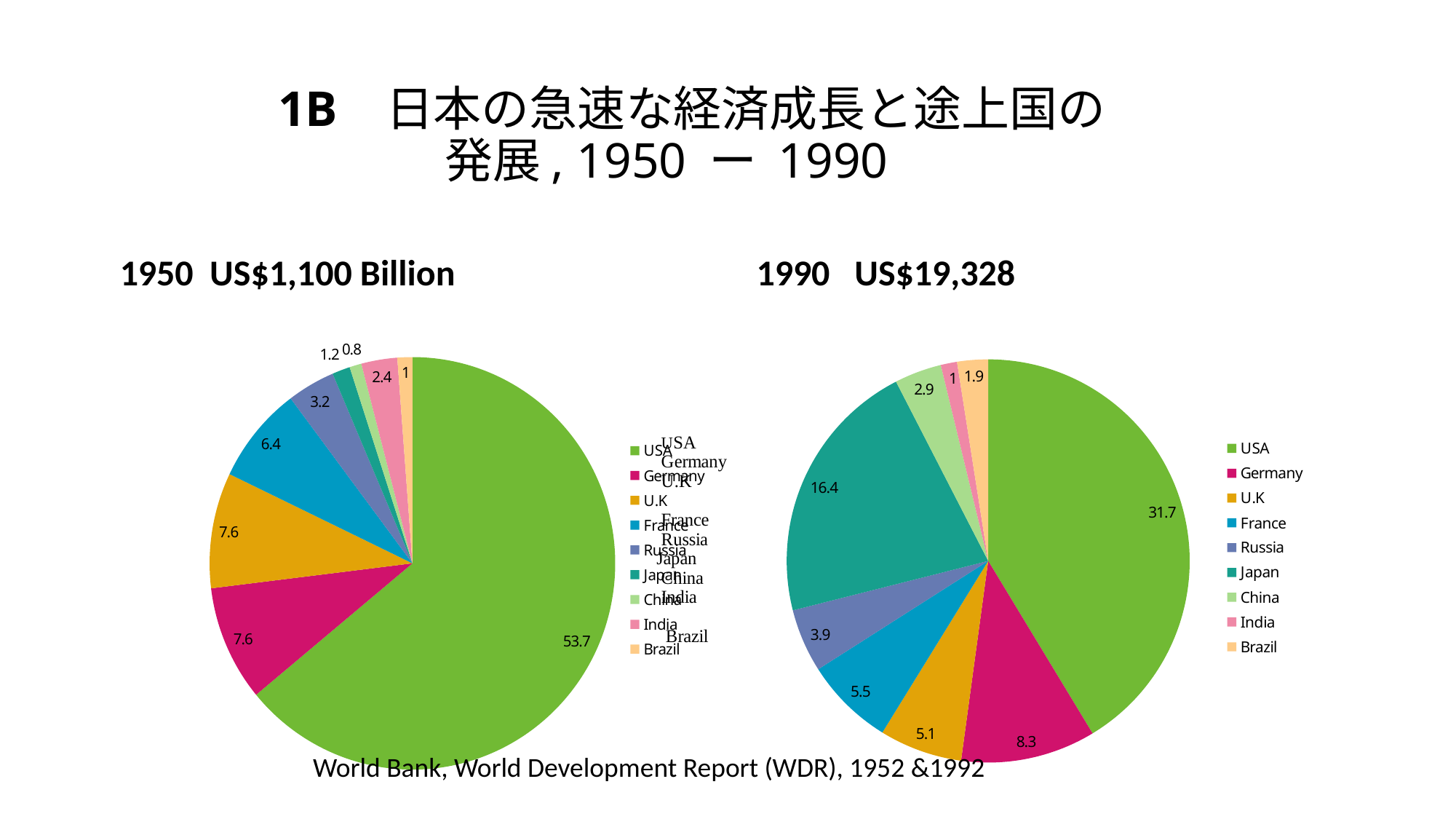
In the 1990 pie chart, which category has the largest slice? USA What total value is shown in the heading above the 1950 pie chart? US$1,100 Billion In the 1990 pie chart, what is the value for Japan? 16.4 In the 1990 pie chart, which category has the smallest slice? India What kind of chart is used for the 1950 data? Pie chart In the 1950 pie chart, what is the value for USA? 53.7 In the 1950 pie chart, what is the value for France? 6.4 In the 1990 pie chart, what is the value for Germany? 8.3 In the 1950 pie chart, which is larger, the value for Russia or the value for India? Russia In the 1990 pie chart, which is larger, the value for France or the value for U.K? France In the 1990 pie chart, what is the difference between the values for USA and Japan? 15.3 How many categories does the legend of the 1990 pie chart list? 9